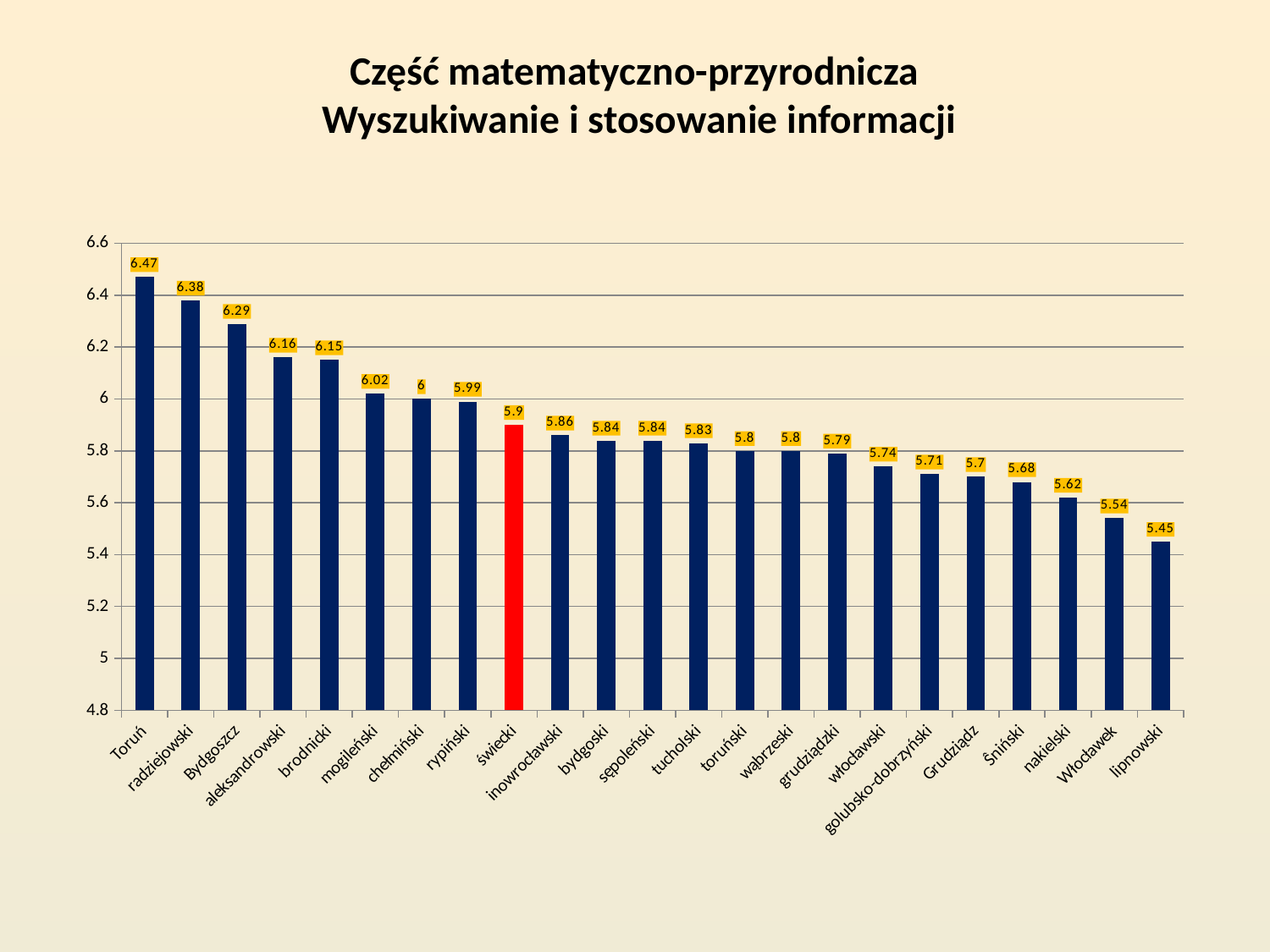
What is the value for świecki? 5.9 What is the value for chełmiński? 6 What is the difference between the values for Toruń and lipnowski? 1.02 What is the value for Grudziądz? 5.7 Which is larger, the value for radziejowski or the value for brodnicki? radziejowski Which category has the highest value? Toruń What is the value for Toruń? 6.47 Which bar is coloured red instead of dark blue? świecki Which category has the lowest value? lipnowski What kind of chart is shown on the slide? bar chart What is the difference between the values for Bydgoszcz and Włocławek? 0.75 How many categories are shown on the x axis? 23